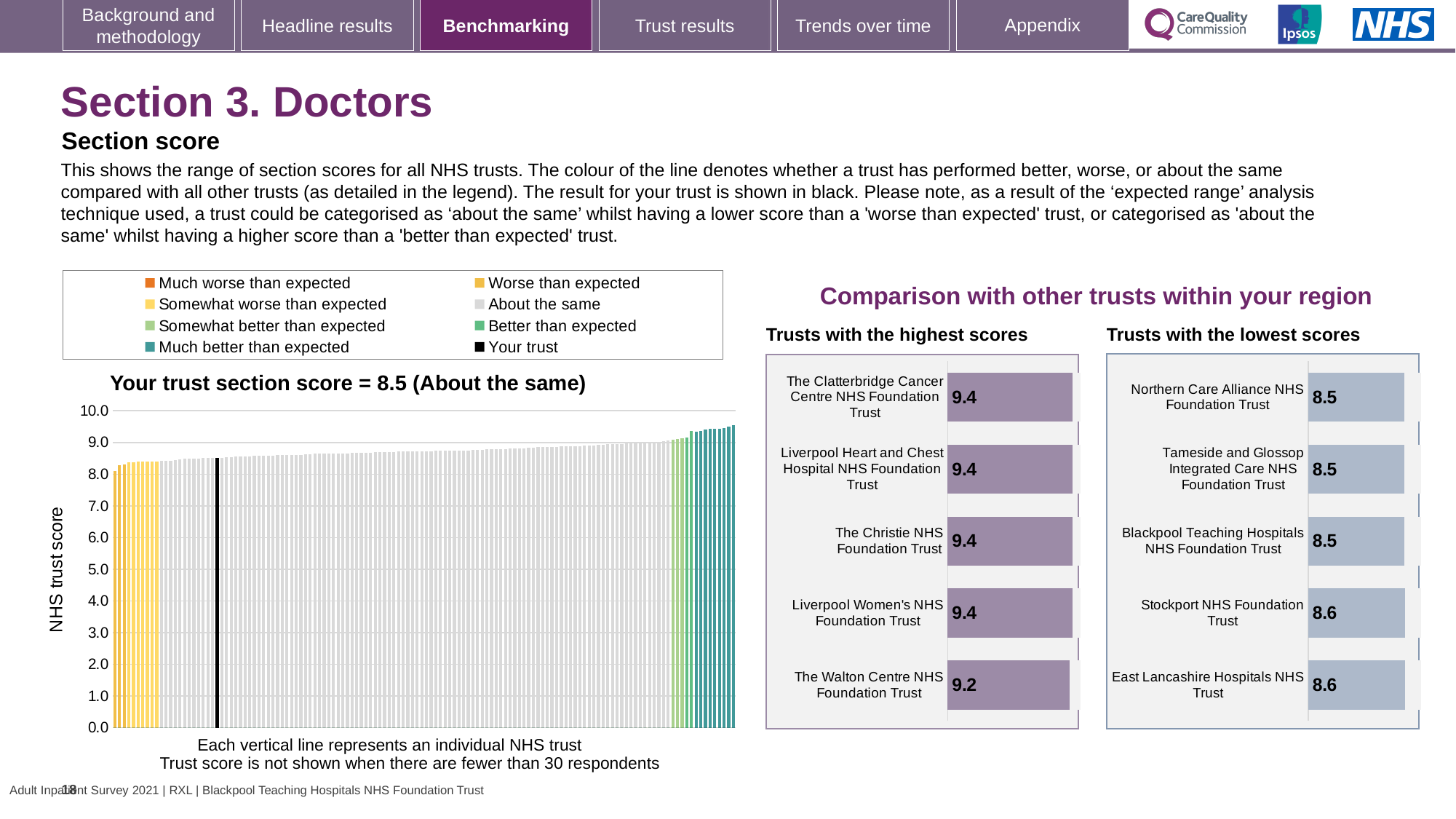
In the 'Trusts with the highest scores' chart, what is the difference between the score for The Christie NHS Foundation Trust and The Walton Centre NHS Foundation Trust? 0.2 In the 'Trusts with the highest scores' chart, what is the score for The Walton Centre NHS Foundation Trust? 9.2 What kind of chart is the main chart titled 'Your trust section score = 8.5 (About the same)'? bar chart In the main chart 'Your trust section score', what is the section score for your trust? 8.5 How many entries does the legend above the main chart list? 8 In the main chart 'Your trust section score', is the value of the highest bar greater or less than 10.0? less Which is larger: the score for The Clatterbridge Cancer Centre NHS Foundation Trust in the 'Trusts with the highest scores' chart or the score for Stockport NHS Foundation Trust in the 'Trusts with the lowest scores' chart? The Clatterbridge Cancer Centre NHS Foundation Trust In the 'Trusts with the lowest scores' chart, what is the difference between the score for East Lancashire Hospitals NHS Trust and Blackpool Teaching Hospitals NHS Foundation Trust? 0.1 In the 'Trusts with the highest scores' chart, how many trusts are shown? 5 In the main chart 'Your trust section score', do the trust scores rise or fall from left to right along the x axis? rise In the 'Trusts with the highest scores' chart, which trust has the lowest score? The Walton Centre NHS Foundation Trust In the 'Trusts with the lowest scores' chart, what is the score for Stockport NHS Foundation Trust? 8.6